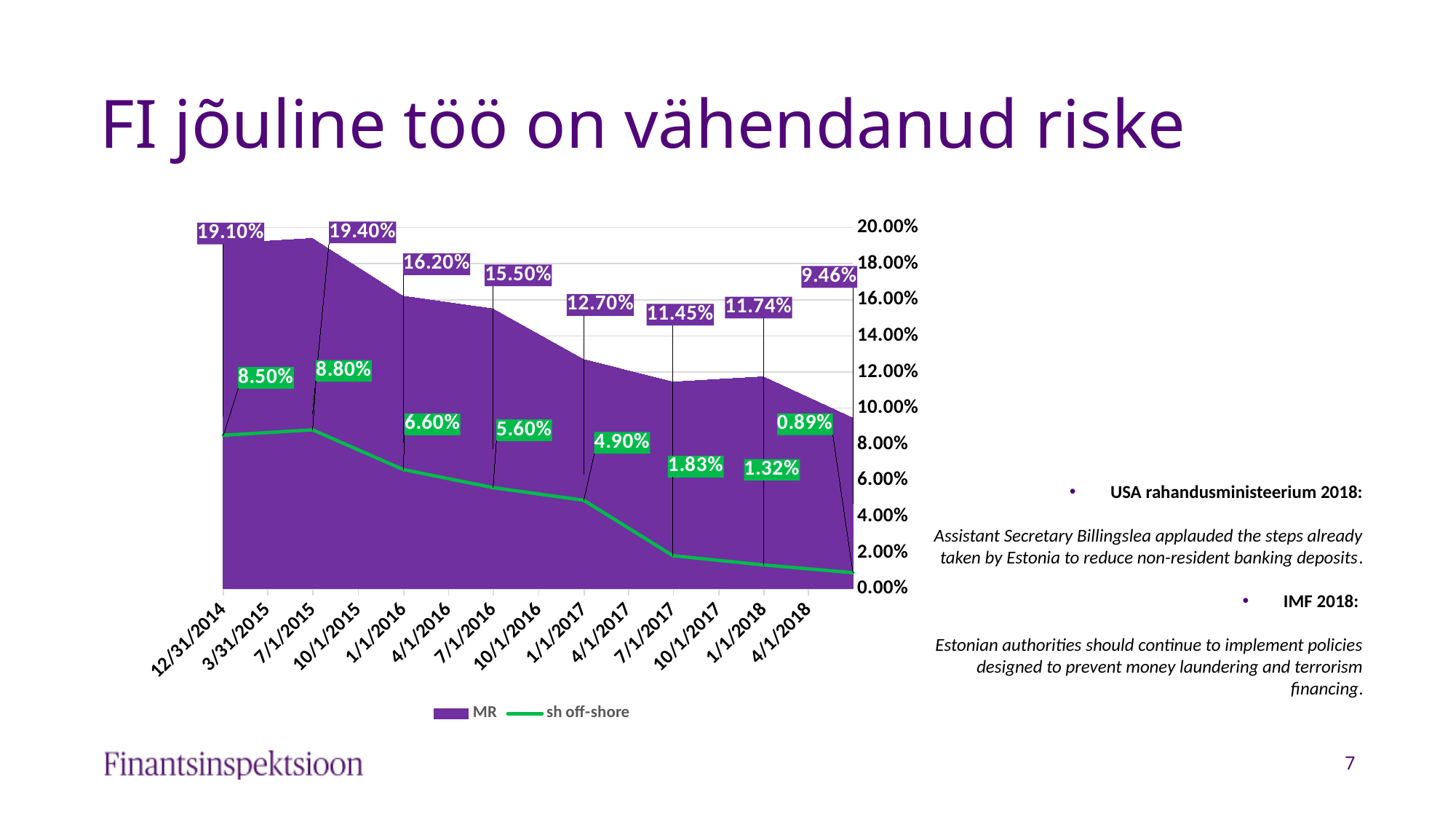
Is the MR value on 4/1/2016 greater or less than 14.00%? greater On which date does the MR series reach its highest labelled value? 7/1/2015 How many series does the legend list? 2 What is the sh off-shore value on 1/1/2017? 4.90% What is the MR value on 7/1/2015? 19.40% Which is larger, the MR value on 7/1/2017 or on 1/1/2018? 1/1/2018 Does the sh off-shore series rise or fall from 12/31/2014 to 4/1/2018? fall How many dates are shown on the x axis? 14 What is the sh off-shore value on 7/1/2017? 1.83%